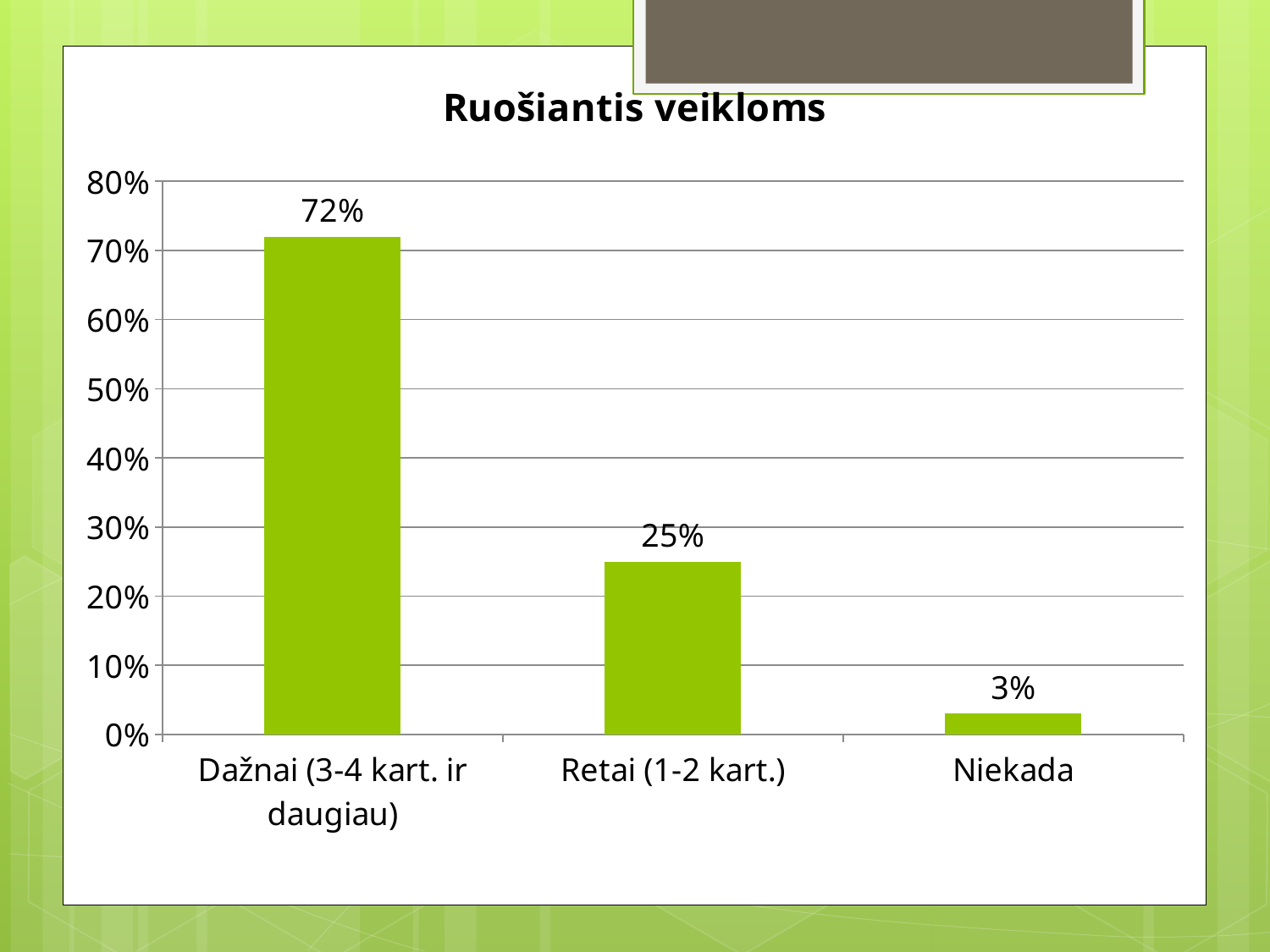
Which category has the lowest value? Niekada What is the value for "Dažnai (3-4 kart. ir daugiau)"? 72% Is the value for "Retai (1-2 kart.)" greater or less than 30%? less What is the difference between the values for "Dažnai (3-4 kart. ir daugiau)" and "Retai (1-2 kart.)"? 47% What kind of chart is shown on the slide? bar chart Which is larger, the value for "Retai (1-2 kart.)" or the value for "Niekada"? Retai (1-2 kart.) What is the difference between the values for "Retai (1-2 kart.)" and "Niekada"? 22% What is the value for "Retai (1-2 kart.)"? 25% What is the value for "Niekada"? 3% What is the title of the chart? Ruošiantis veikloms Which category has the highest value? Dažnai (3-4 kart. ir daugiau) How many categories are shown on the chart? 3